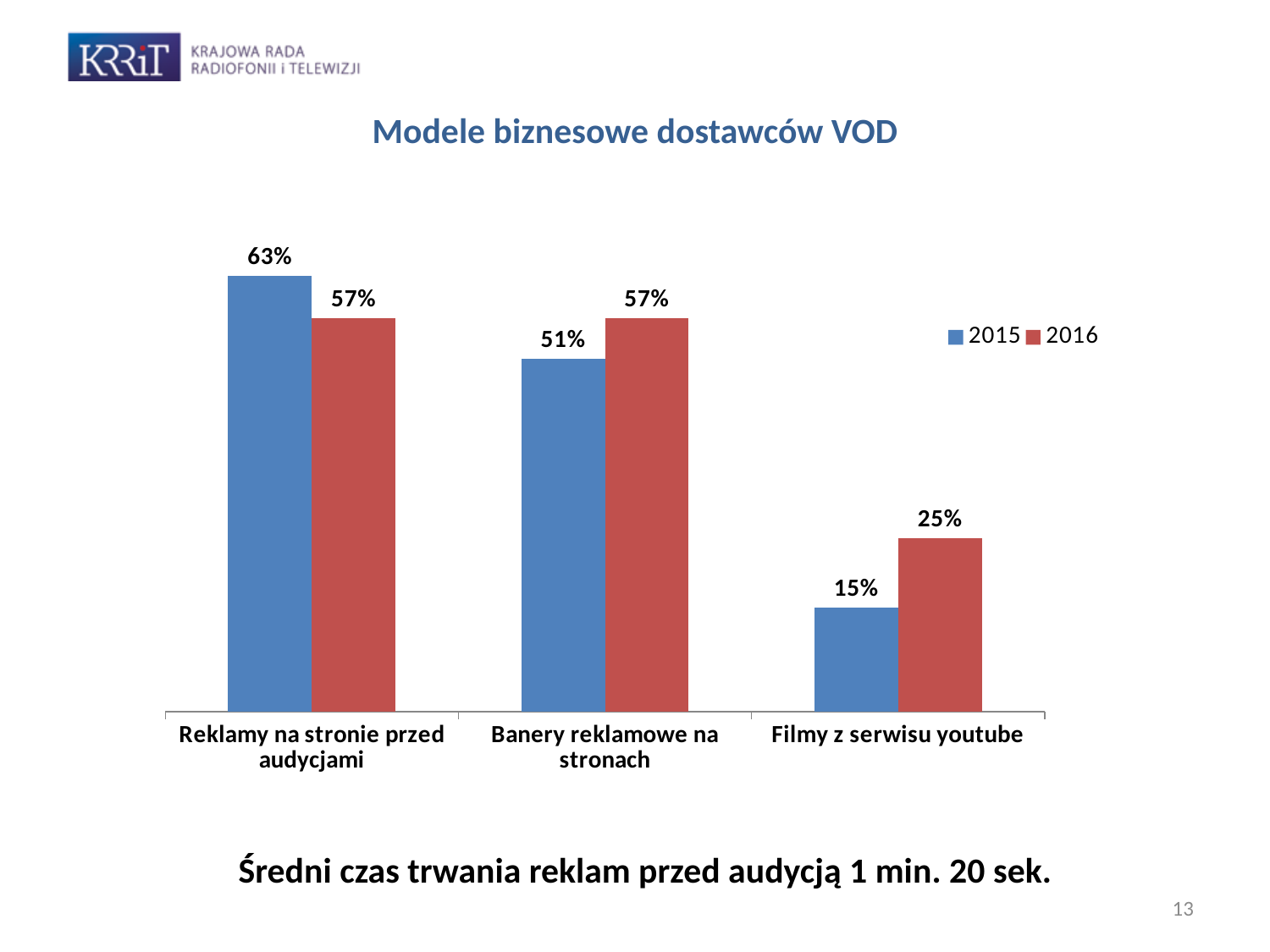
Which category has the highest 2015 value? Reklamy na stronie przed audycjami What is the 2015 value for "Reklamy na stronie przed audycjami"? 63% What kind of chart is shown on the slide? Bar chart How many categories are shown on the x axis? 3 Which category has the lowest 2016 value? Filmy z serwisu youtube How many series does the legend list? 2 Which is larger for "Banery reklamowe na stronach": the 2015 value or the 2016 value? 2016 What is the title of the chart? Modele biznesowe dostawców VOD What is the 2016 value for "Filmy z serwisu youtube"? 25% What is the difference between the 2016 and 2015 values for "Filmy z serwisu youtube"? 10% What is the 2015 value for "Banery reklamowe na stronach"? 51% What is the difference between the 2015 and 2016 values for "Reklamy na stronie przed audycjami"? 6%